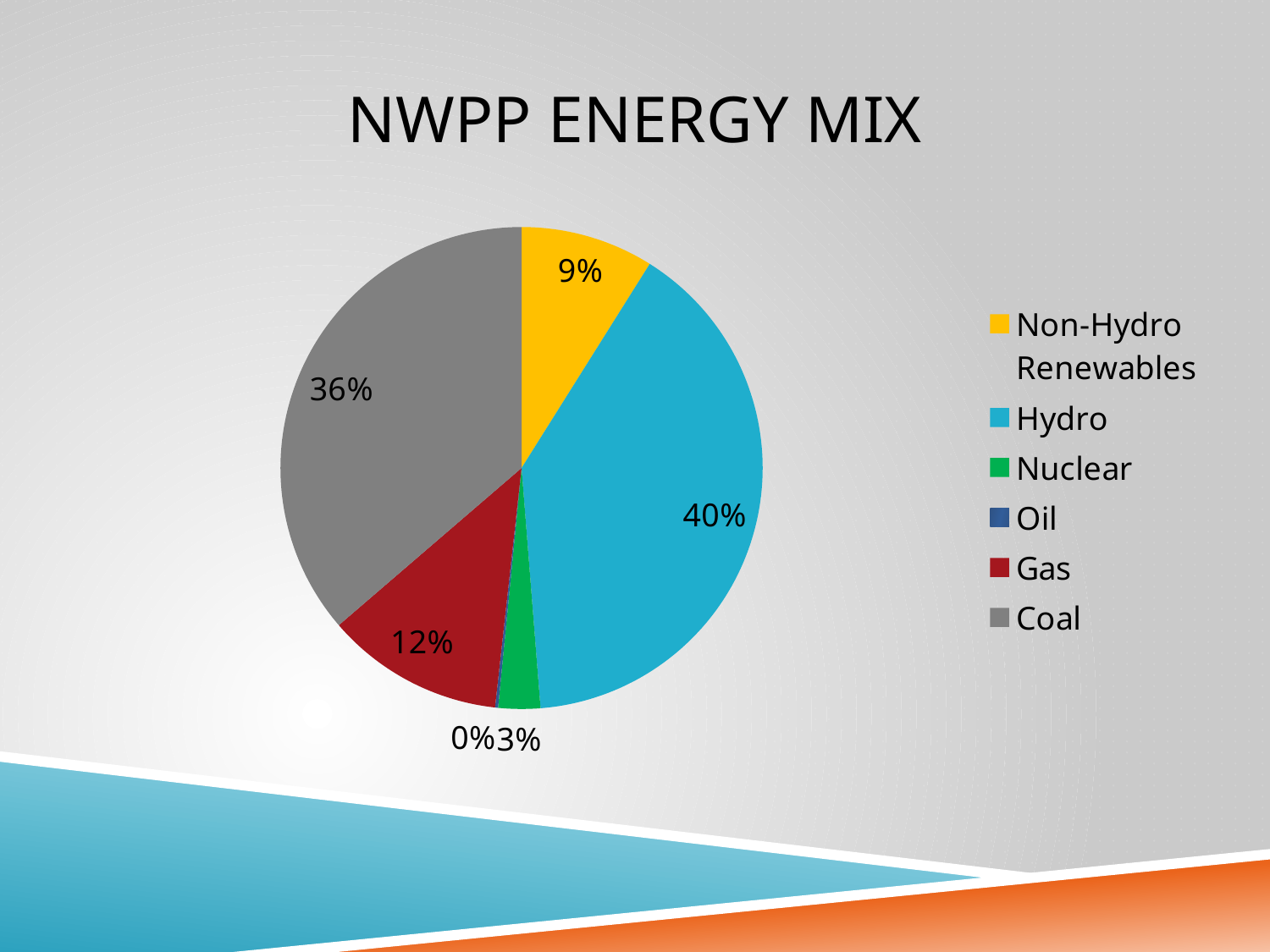
How many energy sources are listed in the legend of the NWPP Energy Mix chart? 6 What share of the NWPP energy mix is Non-Hydro Renewables? 9% Which energy source has the smallest share of the NWPP energy mix? Oil How many percentage points larger is the Coal share than the Gas share? 24 percentage points What colour represents Coal in the NWPP Energy Mix chart? Grey What kind of chart is used to show the NWPP energy mix? Pie chart What share of the NWPP energy mix is Hydro? 40% What share of the NWPP energy mix is Gas? 12% What share of the NWPP energy mix is Coal? 36% What share of the NWPP energy mix is Nuclear? 3% Which has a larger share of the NWPP energy mix, Gas or Non-Hydro Renewables? Gas Which energy source has the largest share of the NWPP energy mix? Hydro